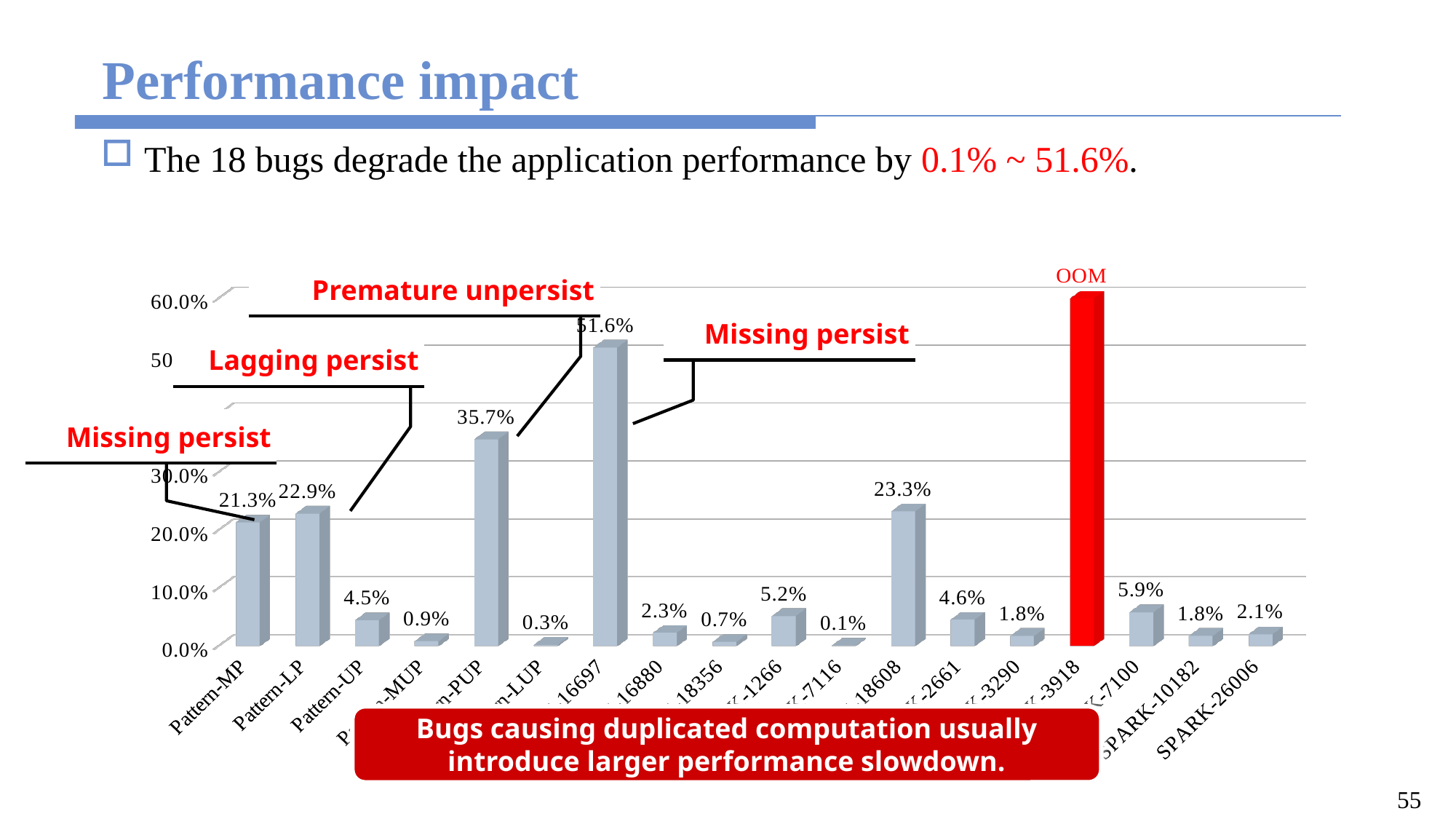
Which is larger, the value for Pattern-UP or the value for SPARK-26006? Pattern-UP What is the lowest percentage value labeled on the chart? 0.1% Is the red bar labeled OOM greater or less than 50%? greater What is the value for Pattern-UP? 4.5% How many bars are plotted on the chart? 18 What kind of chart is shown on the slide? bar chart What is the difference between the values for Pattern-LP and Pattern-MP? 1.6% What is the value for Pattern-LP? 22.9% What is the value for SPARK-26006? 2.1% What is the value for Pattern-MP? 21.3% What is the highest percentage value labeled on the chart? 51.6% What is the value for SPARK-10182? 1.8%